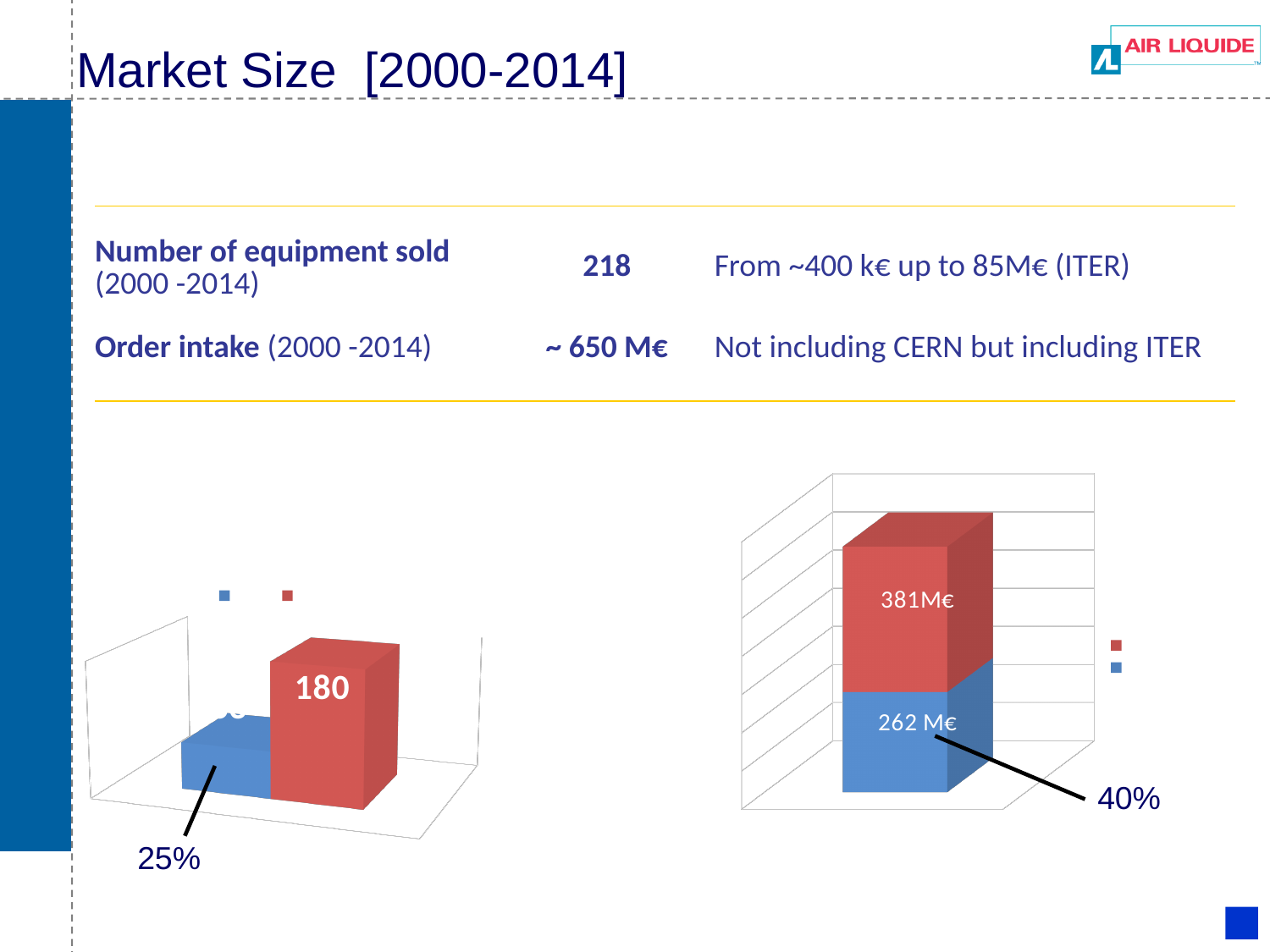
In the chart on the right of the slide, what value is printed on the red segment? 381M€ In the chart on the right of the slide, what value is printed on the blue segment? 262 M€ In the chart on the left of the slide, what value is printed on the red bar? 180 In the chart on the right of the slide, which segment is larger, the red one or the blue one? the red one In the chart on the left of the slide, which bar is taller, the blue bar or the red bar? the red bar What kind of chart is the chart on the right of the slide? stacked bar chart In the chart on the right of the slide, what is the difference between the red segment and the blue segment? 119 M€ What kind of chart is the chart on the left of the slide? bar chart In the chart on the left of the slide, what percentage is annotated next to the blue bar? 25% In the chart on the right of the slide, what is the total of the stacked bar? 643 M€ How many series does the legend of the chart on the left of the slide list? 2 How many bars are plotted in the chart on the left of the slide? 2